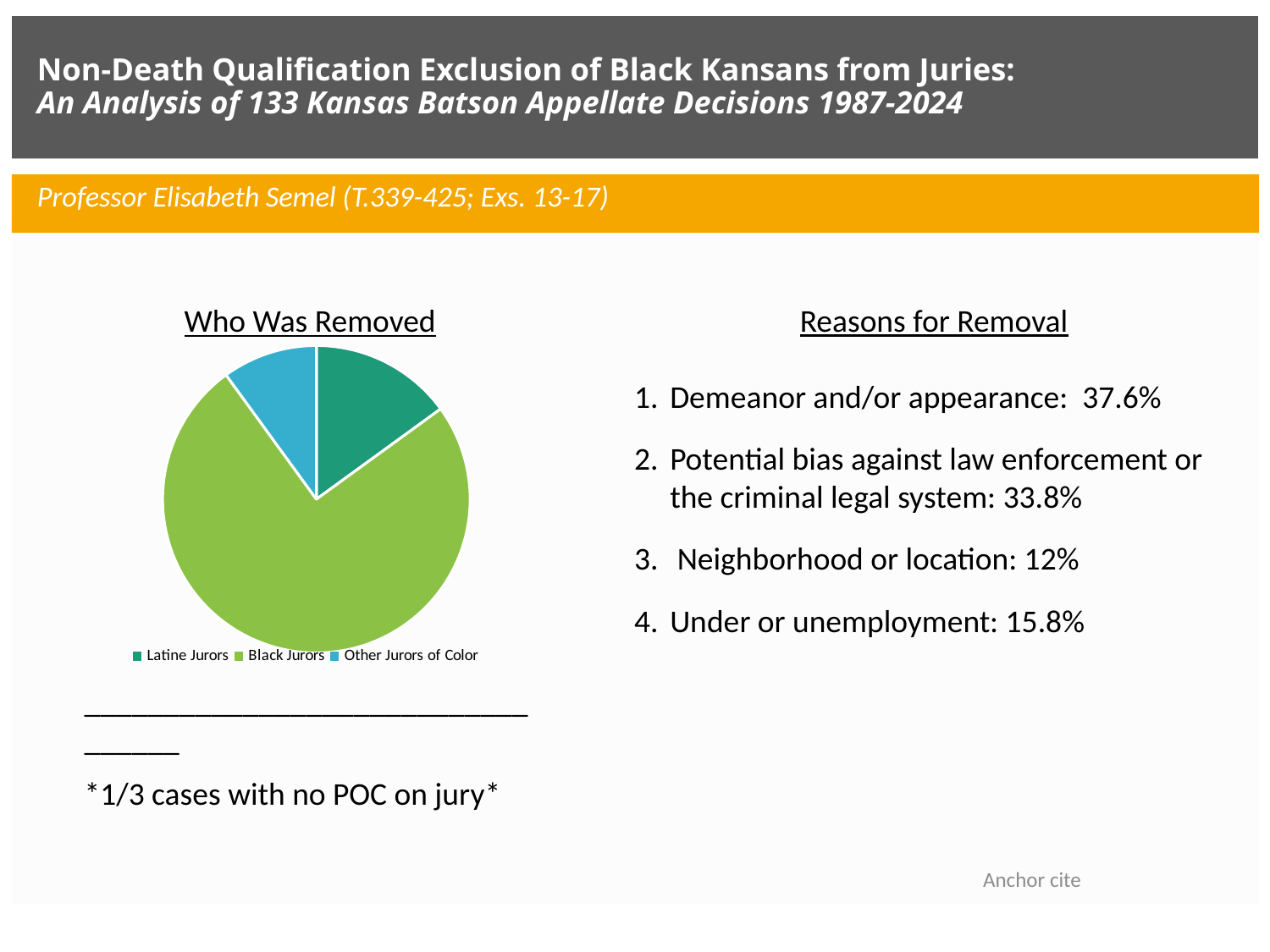
Does the pie chart's largest slice represent more or less than half of the pie? More What kind of chart is shown on the slide? Pie chart Which slice is larger in the pie chart, Black Jurors or Latine Jurors? Black Jurors Which category has the smallest slice in the pie chart? Other Jurors of Color What is the title of the pie chart? Who Was Removed Which category is shown in light green in the pie chart? Black Jurors How many entries does the legend of the pie chart list? 3 How many slices does the pie chart have? 3 Which slice is larger in the pie chart, Latine Jurors or Other Jurors of Color? Latine Jurors Which category has the largest slice in the pie chart? Black Jurors